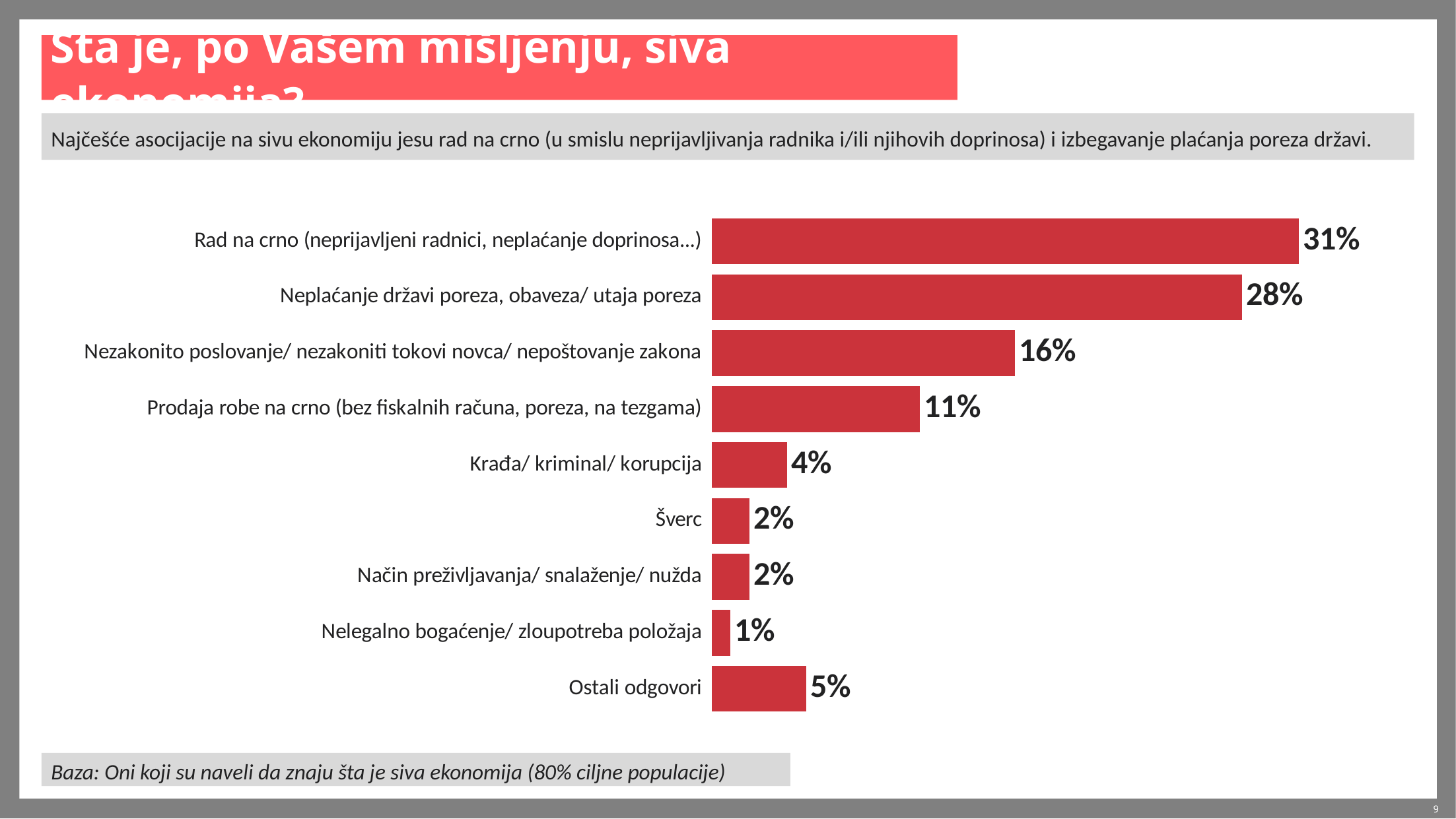
What is the difference between the values for "Nezakonito poslovanje/ nezakoniti tokovi novca/ nepoštovanje zakona" and "Krađa/ kriminal/ korupcija"? 12% What is the value for "Neplaćanje državi poreza, obaveza/ utaja poreza"? 28% What kind of chart is shown on the slide? Bar chart What is the value for "Ostali odgovori"? 5% What is the difference between the values for "Rad na crno" and "Neplaćanje državi poreza, obaveza/ utaja poreza"? 3% Which is larger, the value for "Ostali odgovori" or the value for "Krađa/ kriminal/ korupcija"? Ostali odgovori How many categories are shown in the chart? 9 What is the value for "Rad na crno (neprijavljeni radnici, neplaćanje doprinosa...)"? 31% What is the value for "Prodaja robe na crno (bez fiskalnih računa, poreza, na tezgama)"? 11% Which category has the lowest value? Nelegalno bogaćenje/ zloupotreba položaja What colour are the bars in the chart? Red Which category has the highest value? Rad na crno (neprijavljeni radnici, neplaćanje doprinosa...)